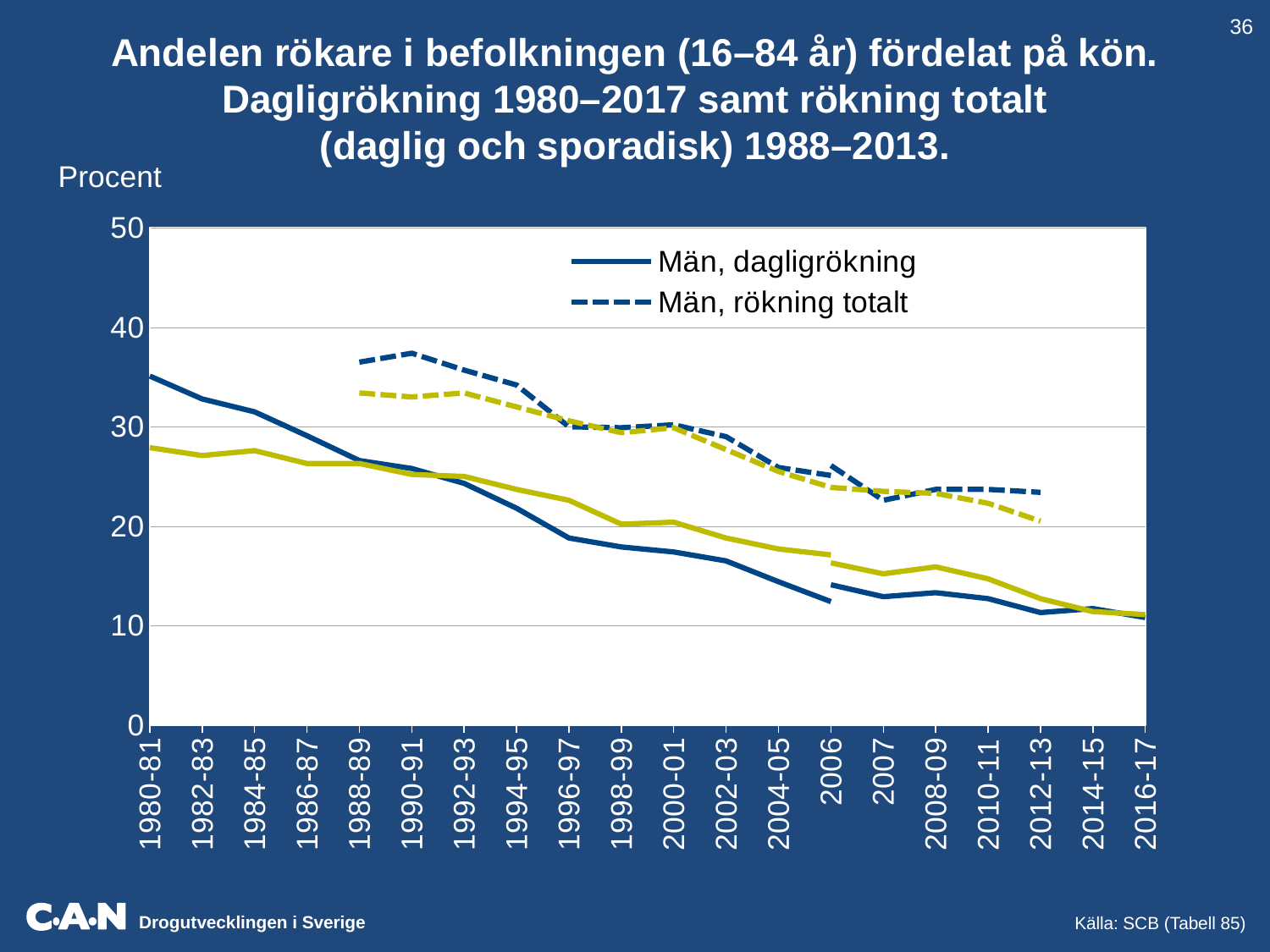
What kind of chart is shown on the slide? line chart How many series does the legend list? 2 Is the value for Män, rökning totalt in 2012-13 greater or less than 20? greater Does the Män, rökning totalt line rise or fall from 1988-89 to 2012-13? fall Is the value for Män, dagligrökning in 1998-99 greater or less than 20? less In 1990-91, which is larger: Män, dagligrökning or Män, rökning totalt? Män, rökning totalt Is the value for Män, dagligrökning in 1980-81 greater or less than 30? greater How many period labels are shown on the x axis? 20 Does the Män, dagligrökning line rise or fall from 1980-81 to 2016-17? fall What unit is shown above the y axis? Procent